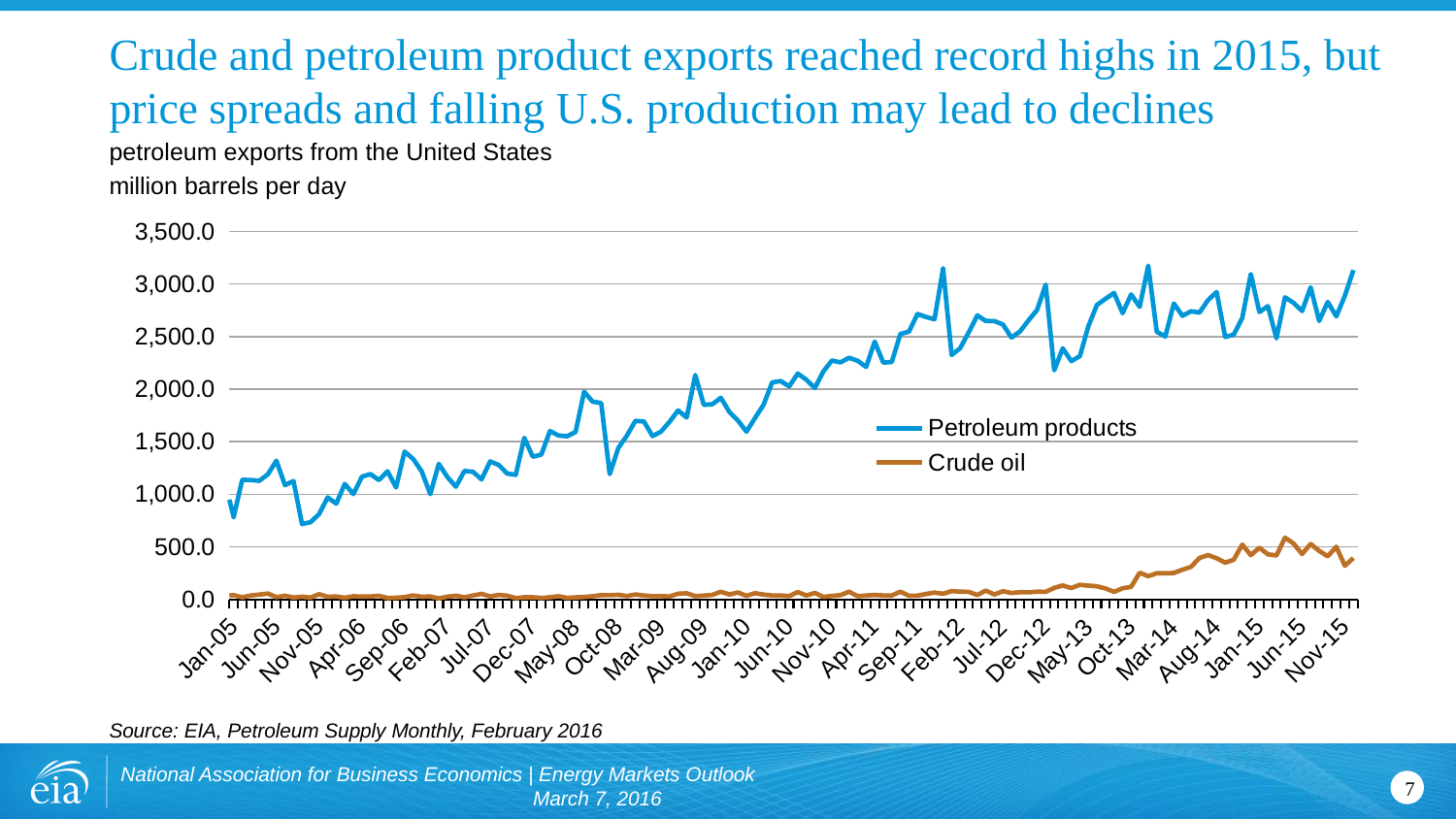
What kind of chart is shown on the slide? line chart Which series has the higher values across the whole period, Petroleum products or Crude oil? Petroleum products Does the Crude oil series rise or fall between Oct-13 and Aug-14? rise Is the value for Crude oil in Jan-05 greater or less than 500.0? less Is the value for Petroleum products in Nov-15 greater or less than 2,500.0? greater What are the two series named in the legend? Petroleum products and Crude oil Is the value for Crude oil in Jun-15 greater or less than 1,000.0? less How many series does the legend list? 2 Does the Petroleum products series generally rise or fall from Jan-05 to Nov-15? rise What unit is used on the y axis of the chart? million barrels per day